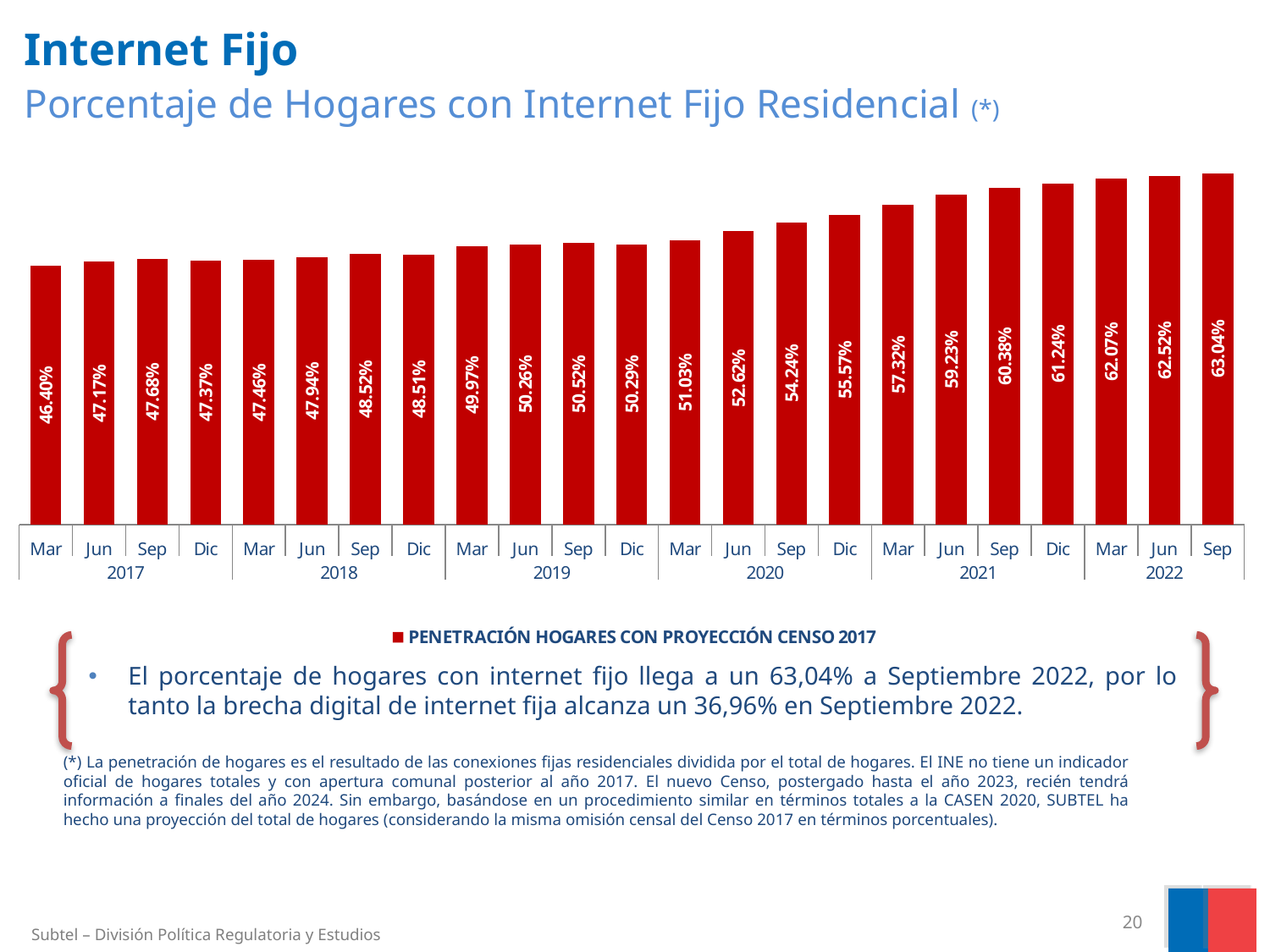
What is the value for Sep 2022? 63,04% What series name does the legend show? PENETRACIÓN HOGARES CON PROYECCIÓN CENSO 2017 What kind of chart is shown on the slide? Bar chart Which period has the highest value? Sep 2022 What is the value for Dic 2020? 55,57% What is the value for Jun 2019? 50,26% What is the value for Mar 2017? 46,40% Which period has the lowest value? Mar 2017 Which is larger, the value for Sep 2017 or the value for Dic 2017? Sep 2017 What is the difference between the values for Sep 2022 and Mar 2017? 16,64 percentage points How many bars are plotted in the chart? 23 What is the difference between the values for Dic 2020 and Dic 2019? 5,28 percentage points